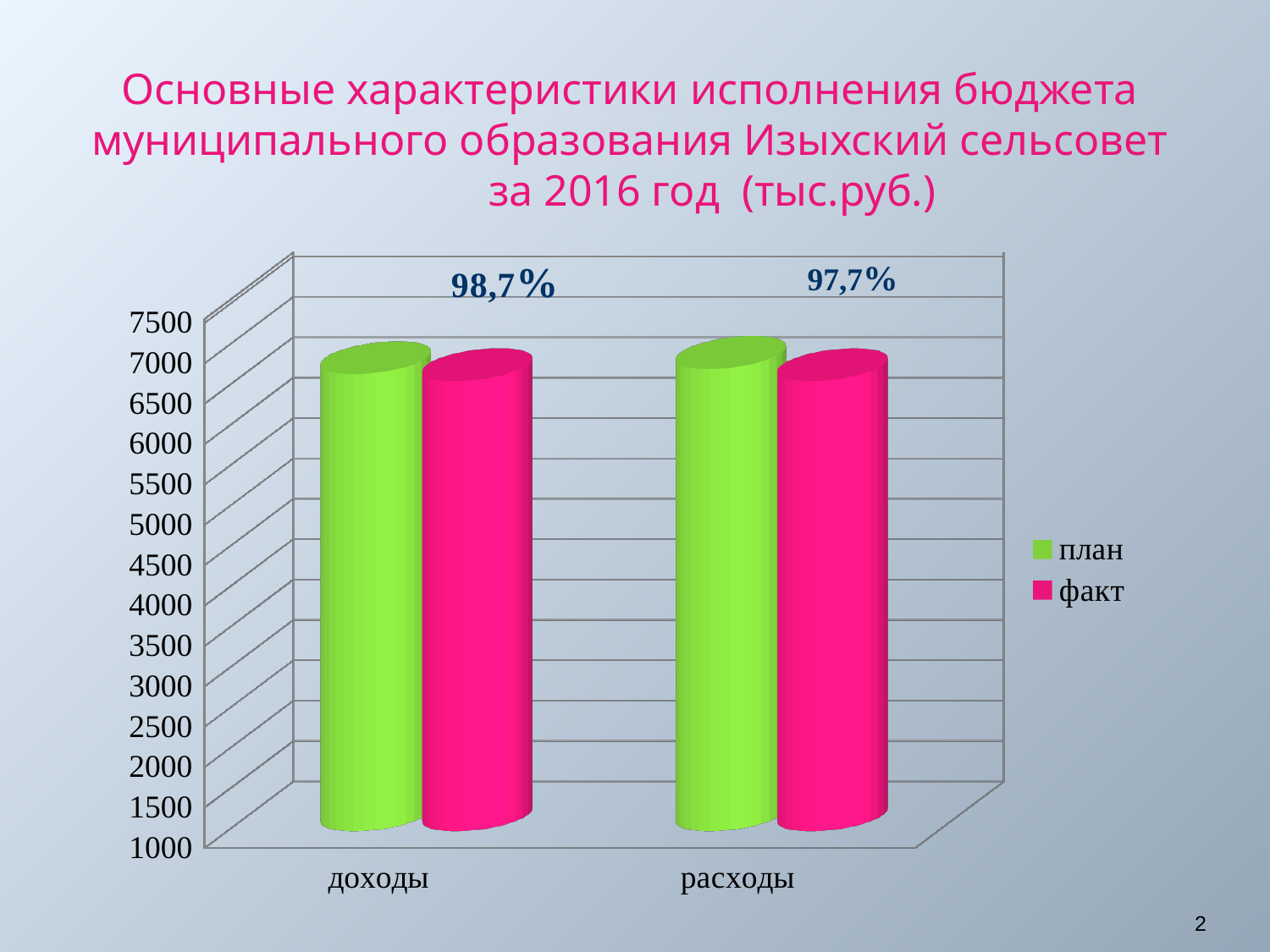
Is the план value for доходы greater or less than 6500? greater Is the факт value for доходы greater or less than 5000? greater What percentage is printed above the доходы bars? 98,7% Is the план value for расходы greater or less than 6500? greater What are the two entries in the chart legend? план, факт What kind of chart is shown on the slide? bar chart How many series does the chart legend list? 2 What percentage is printed above the расходы bars? 97,7% Which colour represents the план series in the chart? green How many categories are shown on the x axis of the chart? 2